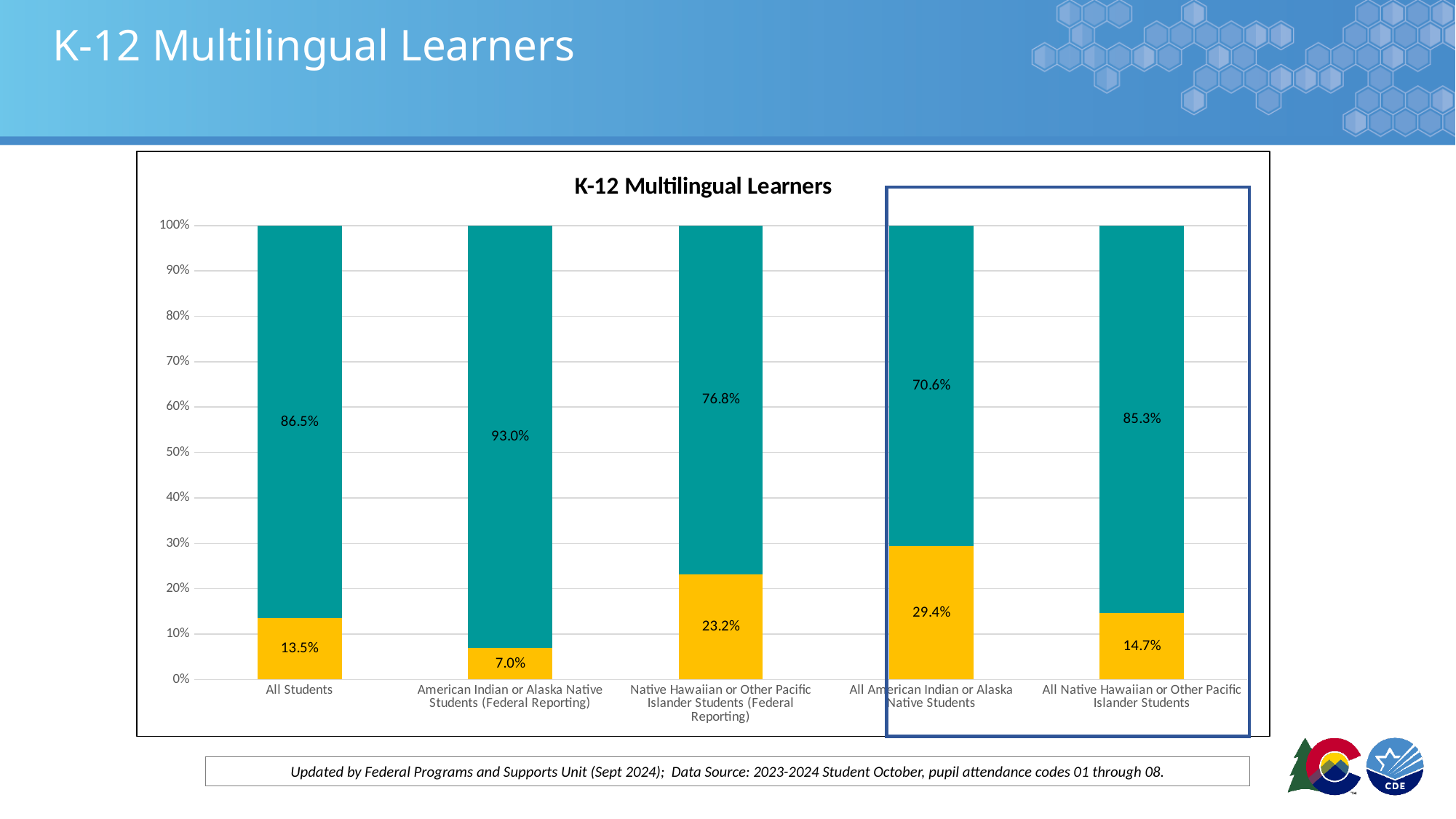
Which category has the largest yellow segment? All American Indian or Alaska Native Students What is the title of the chart? K-12 Multilingual Learners What kind of chart is shown on the slide? Stacked bar chart What is the value of the yellow segment for All Students? 13.5% What is the value of the teal segment for All Native Hawaiian or Other Pacific Islander Students? 85.3% What is the difference between the yellow segment for Native Hawaiian or Other Pacific Islander Students (Federal Reporting) and the yellow segment for All Students? 9.7% What is the value of the teal segment for American Indian or Alaska Native Students (Federal Reporting)? 93.0% Is the yellow segment larger for All Students or for All Native Hawaiian or Other Pacific Islander Students? All Native Hawaiian or Other Pacific Islander Students How many categories are shown on the x axis? 5 Which category has the smallest yellow segment? American Indian or Alaska Native Students (Federal Reporting) What is the total of the stacked bar for All American Indian or Alaska Native Students? 100.0% What is the value of the yellow segment for All American Indian or Alaska Native Students? 29.4%